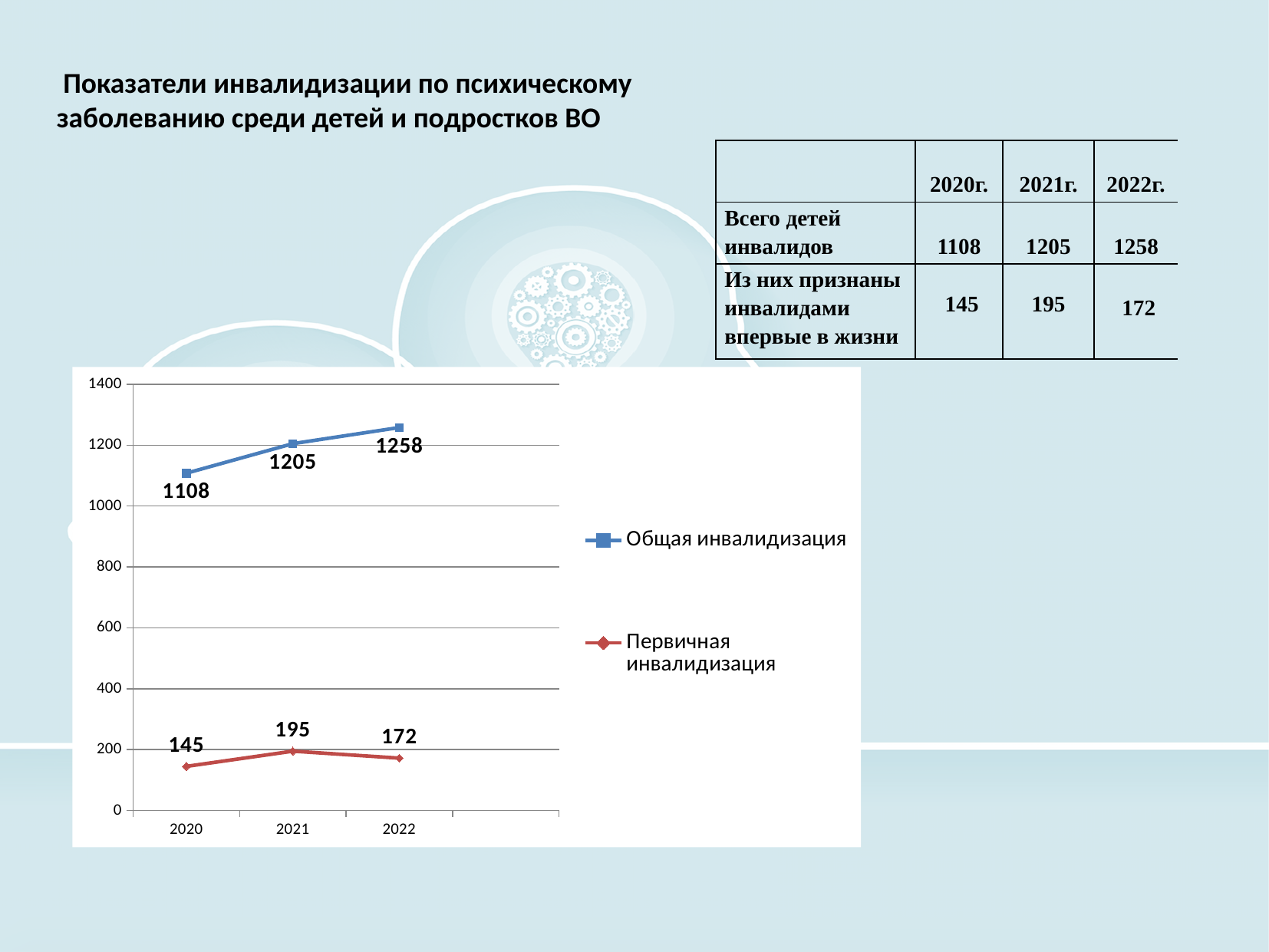
How many series does the legend list? 2 What is the difference between Общая инвалидизация in 2022 and in 2020? 150 What is the difference between Первичная инвалидизация in 2021 and in 2022? 23 What is the value of Общая инвалидизация in 2020? 1108 In which year is Общая инвалидизация lowest? 2020 How many years are plotted on the x axis? 3 Does Общая инвалидизация rise or fall from 2020 to 2022? rise In which year is Первичная инвалидизация highest? 2021 Which is larger: Первичная инвалидизация in 2020 or in 2022? 2022 What kind of chart is shown? line chart What is the value of Первичная инвалидизация in 2021? 195 What is the value of Общая инвалидизация in 2022? 1258